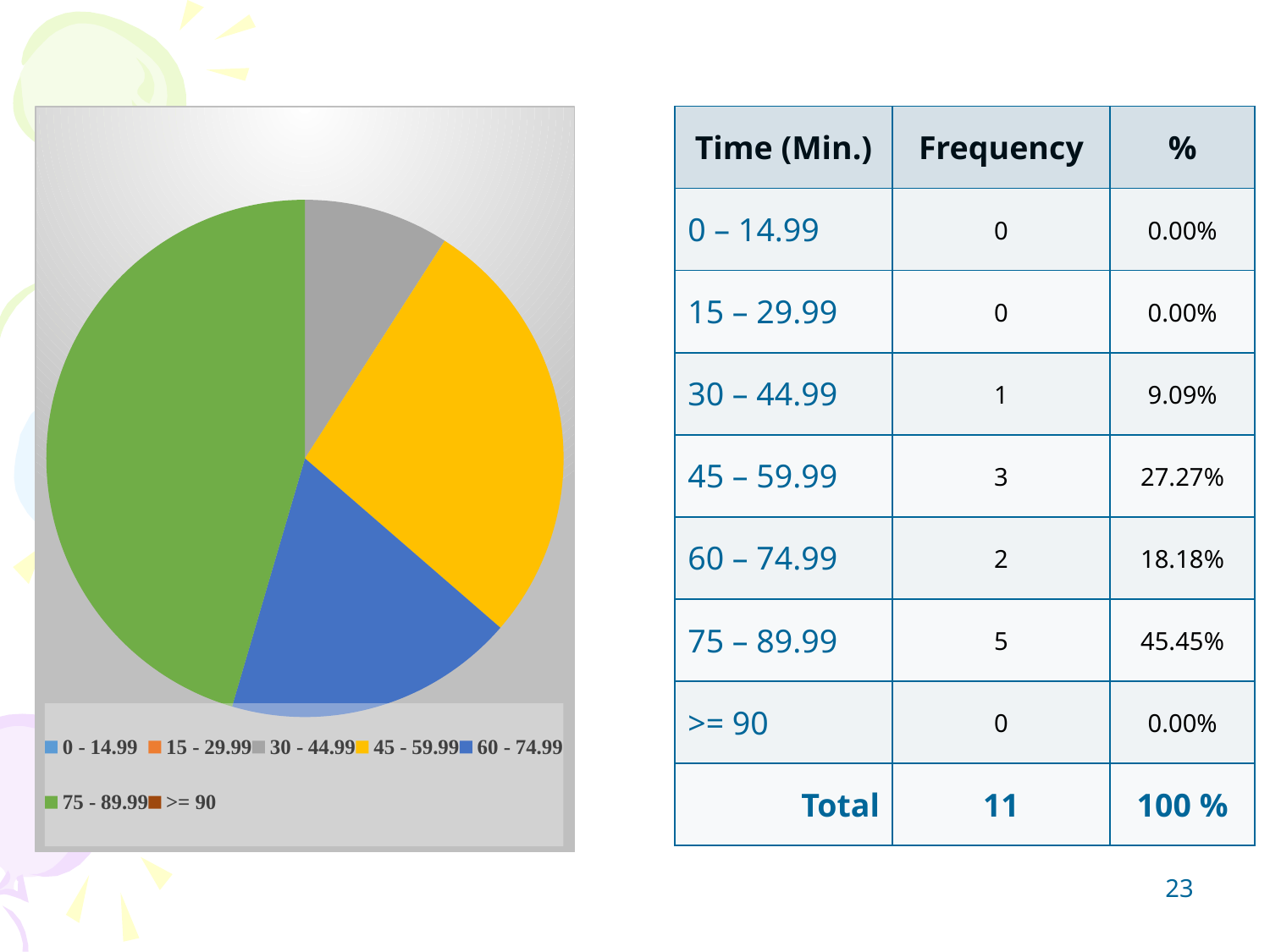
What colour is the 75 - 89.99 slice in the pie chart? green According to the table, what percentage share does the 45 – 59.99 interval have? 27.27% According to the table, what is the difference in frequency between the 75 – 89.99 and 60 – 74.99 intervals? 3 Which category has the largest slice in the pie chart? 75 - 89.99 What colour is the 45 - 59.99 slice in the pie chart? yellow What is the total frequency shown in the table? 11 According to the table, what is the frequency for the 75 – 89.99 time interval? 5 What kind of chart is shown on the left of the slide? pie chart According to the table, what percentage share does the 75 – 89.99 interval have? 45.45% In the pie chart, which slice is larger: 30 - 44.99 or 60 - 74.99? 60 - 74.99 How many categories does the pie chart's legend list? 7 In the pie chart, which slice is larger: 45 - 59.99 or 60 - 74.99? 45 - 59.99